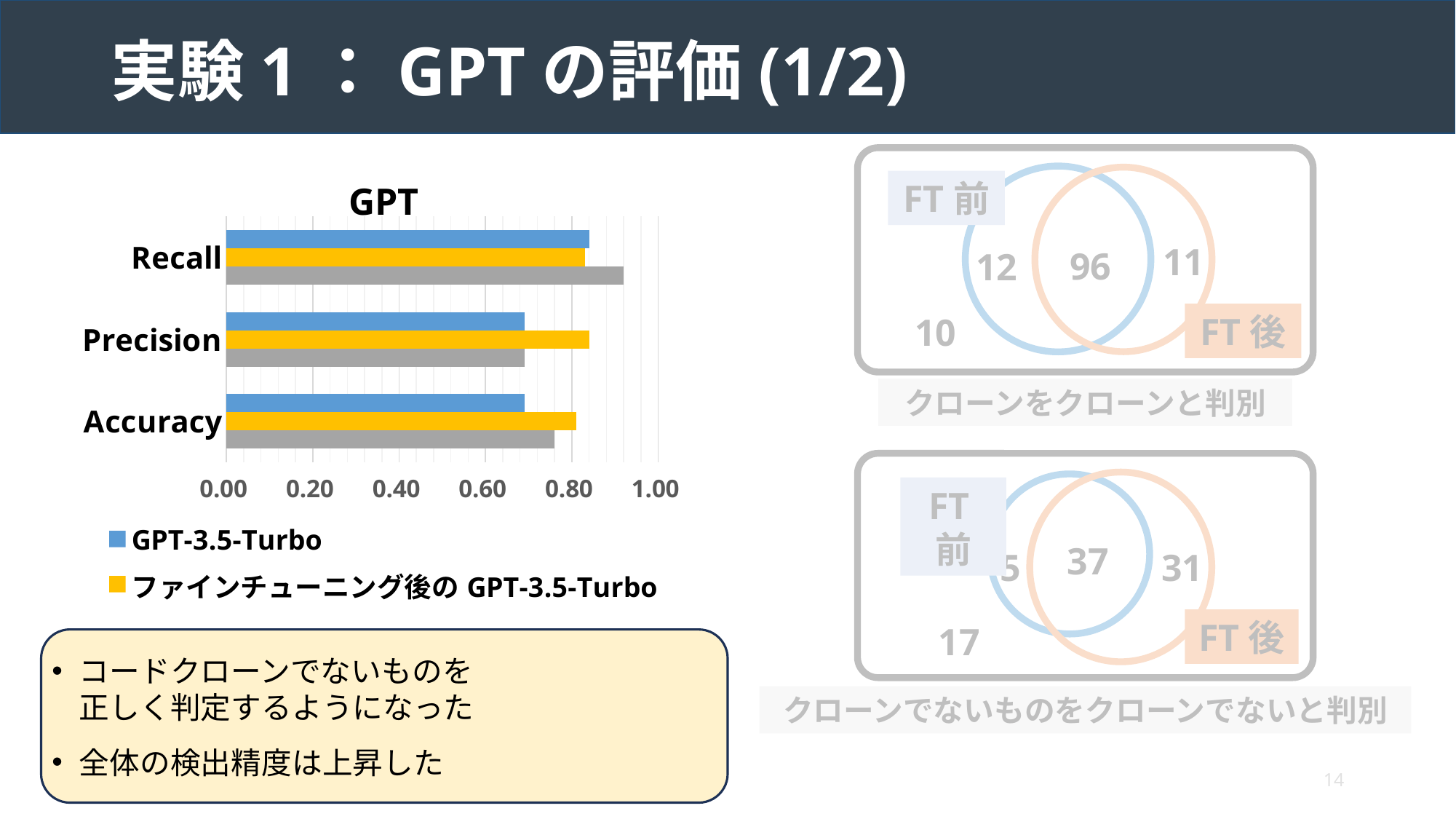
In the "GPT" chart, which colour represents GPT-3.5-Turbo? blue What is the title of the bar chart on the slide? GPT What kind of chart is the chart titled "GPT"? bar chart How many series does the legend of the "GPT" chart list? 2 In the "GPT" chart, for Precision, which is larger: GPT-3.5-Turbo or ファインチューニング後の GPT-3.5-Turbo? ファインチューニング後の GPT-3.5-Turbo In the "GPT" chart, for Accuracy, which is larger: GPT-3.5-Turbo or ファインチューニング後の GPT-3.5-Turbo? ファインチューニング後の GPT-3.5-Turbo How many categories are shown on the y axis of the "GPT" chart? 3 In the "GPT" chart, is the Precision value for ファインチューニング後の GPT-3.5-Turbo greater or less than 0.80? greater In the "GPT" chart, is the Recall value for GPT-3.5-Turbo greater or less than 0.80? greater In the "GPT" chart, which metric has the highest value for GPT-3.5-Turbo? Recall In the "GPT" chart, is the Precision value for GPT-3.5-Turbo greater or less than 0.80? less